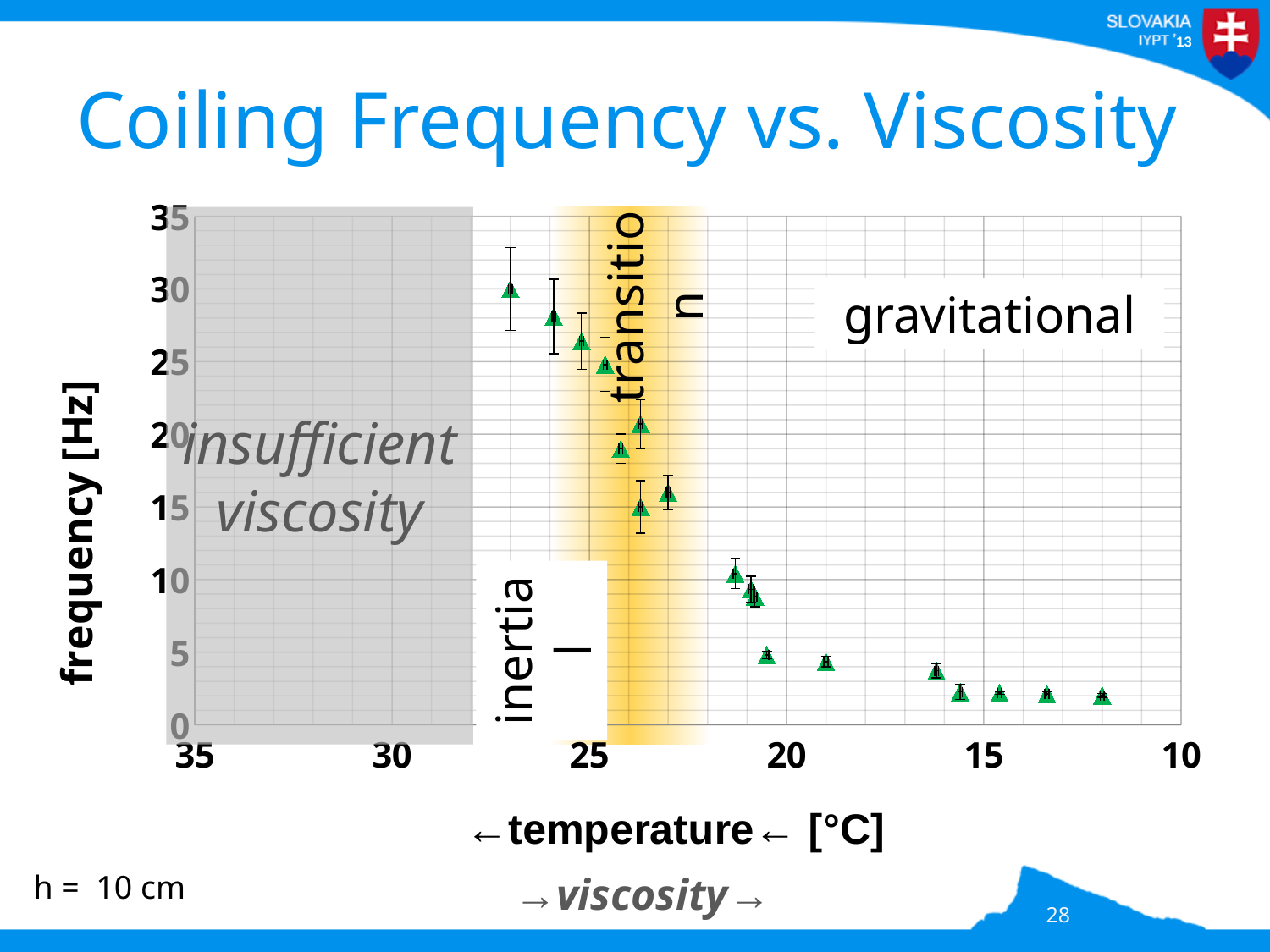
Which data point has the highest frequency: the one at about 27 °C or the one at about 20 °C? the one at about 27 °C Is the frequency measured at about 26 °C greater or less than 20 Hz? greater Is the frequency at about 16 °C greater or less than the frequency at about 24 °C? less Is the frequency measured at about 12 °C greater or less than 5 Hz? less What are the three regime labels written on the chart, from left to right? inertia, transition, gravitational What is the unit of the y axis (frequency)? Hz What kind of chart is shown on the slide? scatter chart Is the frequency measured at about 21 °C greater or less than 5 Hz? greater As temperature decreases along the x axis (from 35 °C toward 10 °C), does the coiling frequency rise or fall? fall